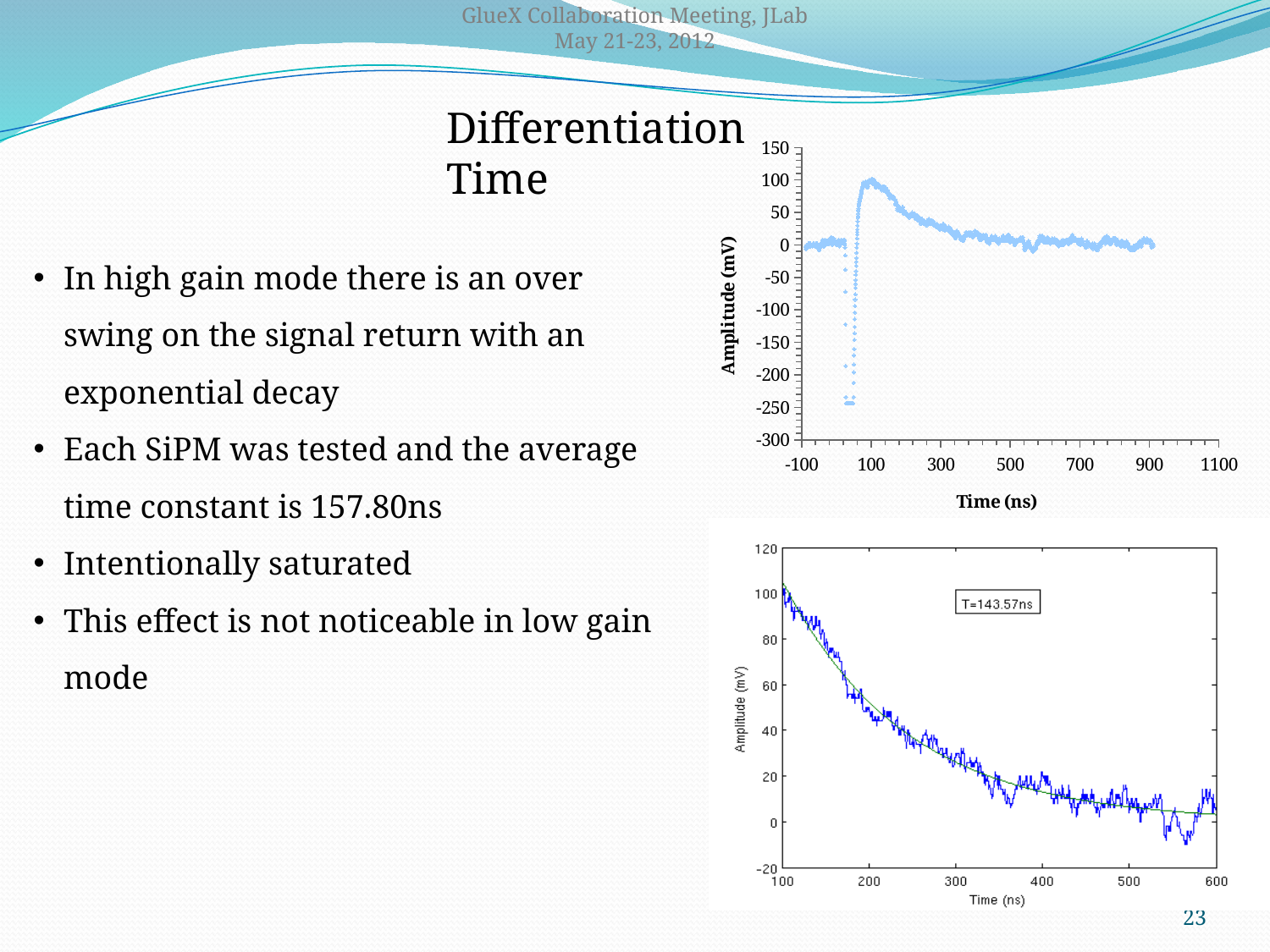
In the top chart, which is larger in absolute amplitude, the negative dip or the positive overshoot? the negative dip In the top chart, is the lowest amplitude reached by the signal greater or less than -200? less In the top chart, what is the label on the y axis? Amplitude (mV) In the bottom chart, is the amplitude at 300 ns greater or less than 60? less In the top chart, is the highest positive amplitude reached by the signal greater or less than 50? greater In the top chart, what is the label on the x axis? Time (ns) What kind of chart is the bottom chart? line chart In the bottom chart, what time constant value is printed in the text box? T=143.57ns In the bottom chart, does the amplitude rise or fall as time increases from 100 ns to 600 ns? fall